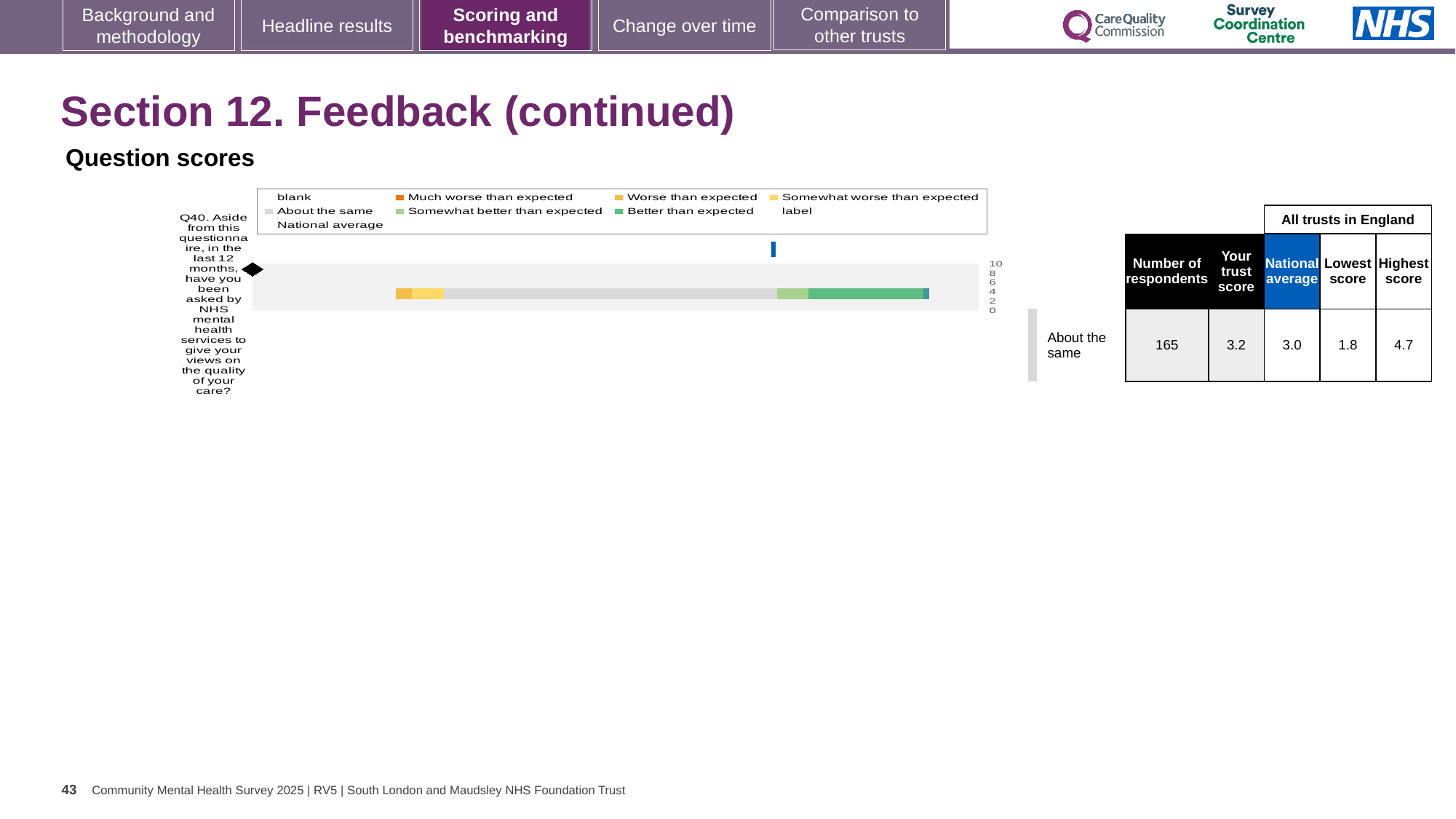
How many questions are plotted in the chart? 1 What is the trust score for Q40? 3.2 How many entries does the chart legend list? 9 What kind of chart is shown on the slide? bar chart What benchmark category is shown for Q40 next to the chart? About the same What is the highest score among all trusts in England for Q40? 4.7 What is the national average score for Q40? 3.0 What is the number of respondents for Q40? 165 Which question number is plotted in the chart? Q40 Which is larger for Q40, the trust score or the national average? trust score What is the difference between the highest score and the lowest score for Q40? 2.9 What is the lowest score among all trusts in England for Q40? 1.8